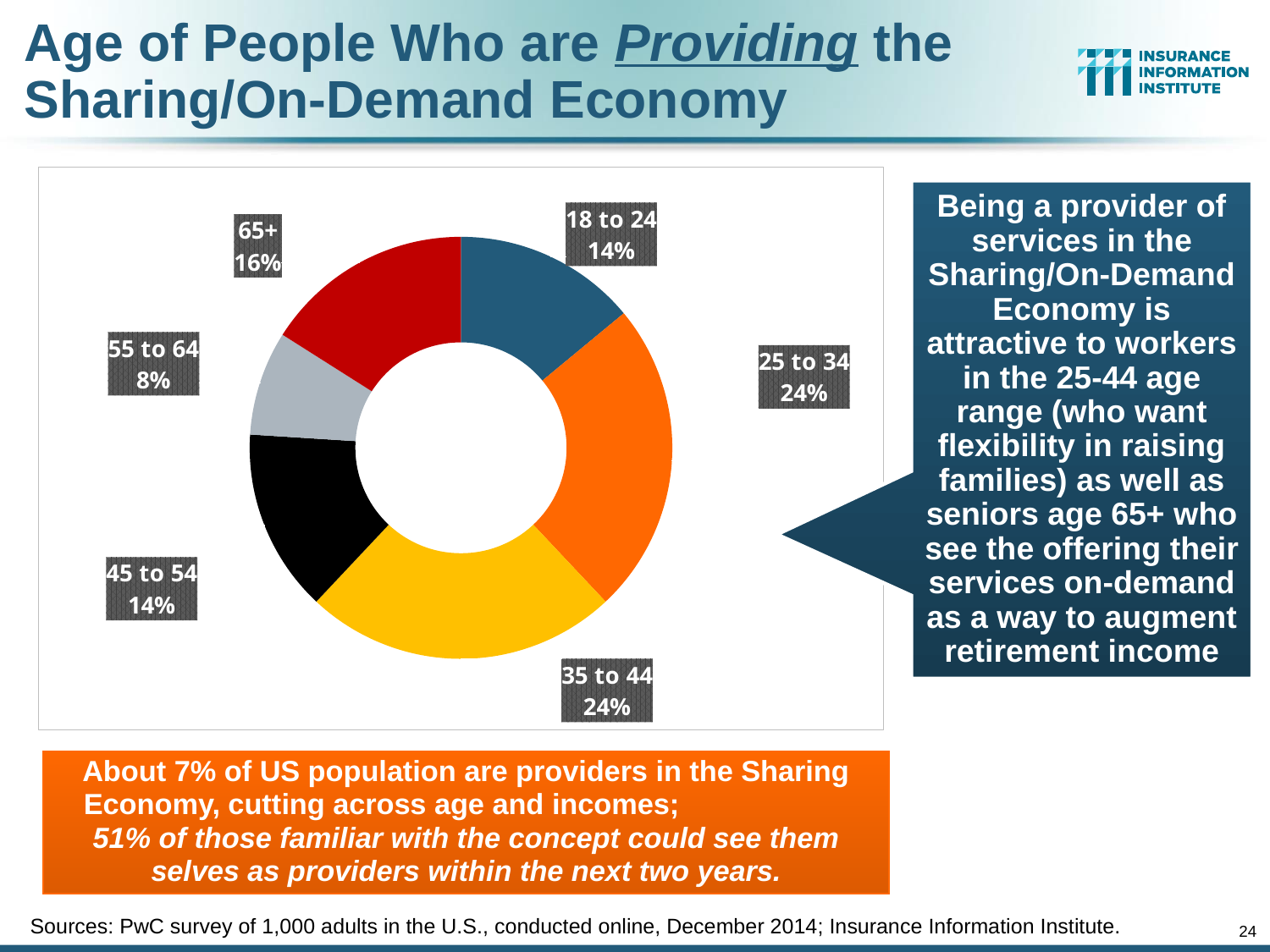
What is the combined share of providers aged 25 to 44 (the 25 to 34 and 35 to 44 slices)? 48% What share of providers are aged 65+? 16% What colour is the slice for the 35 to 44 age group? Yellow What kind of chart is shown on the slide? Pie chart (donut) Which age group has the smallest share of providers? 55 to 64 What share of providers are aged 55 to 64? 8% What is the difference in percentage points between the 65+ share and the 55 to 64 share? 8 percentage points What share of providers are aged 18 to 24? 14% Which two age groups share the largest slice of the chart? 25 to 34 and 35 to 44 What share of providers are aged 25 to 34? 24% How many age categories are shown in the chart? 6 Which is larger, the share for 65+ or the share for 18 to 24? 65+